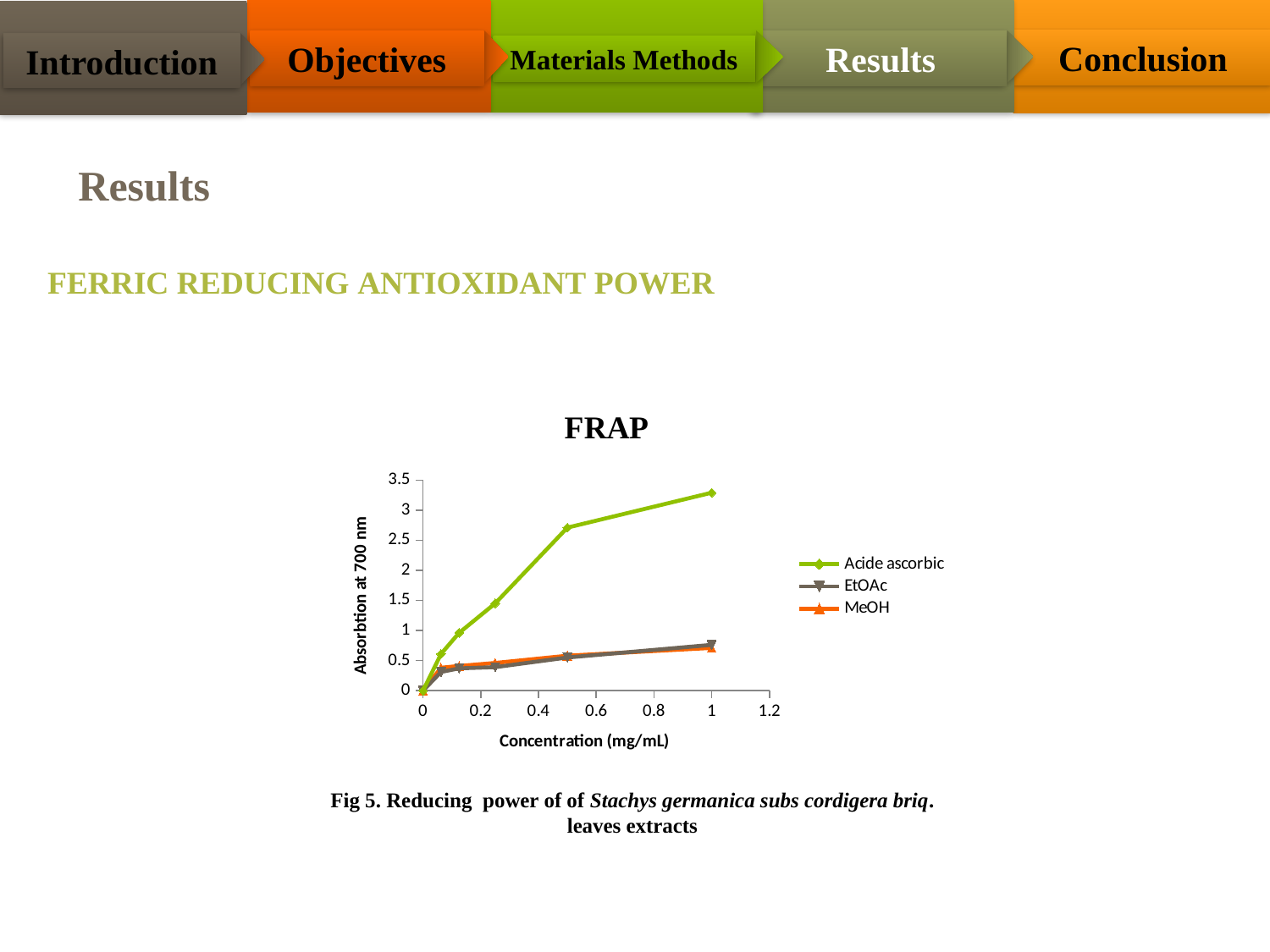
Is the absorption for Acide ascorbic at 1 mg/mL greater or less than 3? greater At 0.5 mg/mL, which has the higher absorption: Acide ascorbic or MeOH? Acide ascorbic Is the absorption for MeOH at 1 mg/mL greater or less than 1? less What is the title of the chart on the slide? FRAP At 1 mg/mL, which has the higher absorption: EtOAc or Acide ascorbic? Acide ascorbic What kind of chart is the FRAP chart? line chart What is the x-axis label of the FRAP chart? Concentration (mg/mL) Does the absorption for Acide ascorbic rise or fall as concentration increases? rise Is the absorption for Acide ascorbic at 0.5 mg/mL greater or less than 2.5? greater Which series has the highest absorption at a concentration of 1 mg/mL in the FRAP chart? Acide ascorbic How many series does the legend of the FRAP chart list? 3